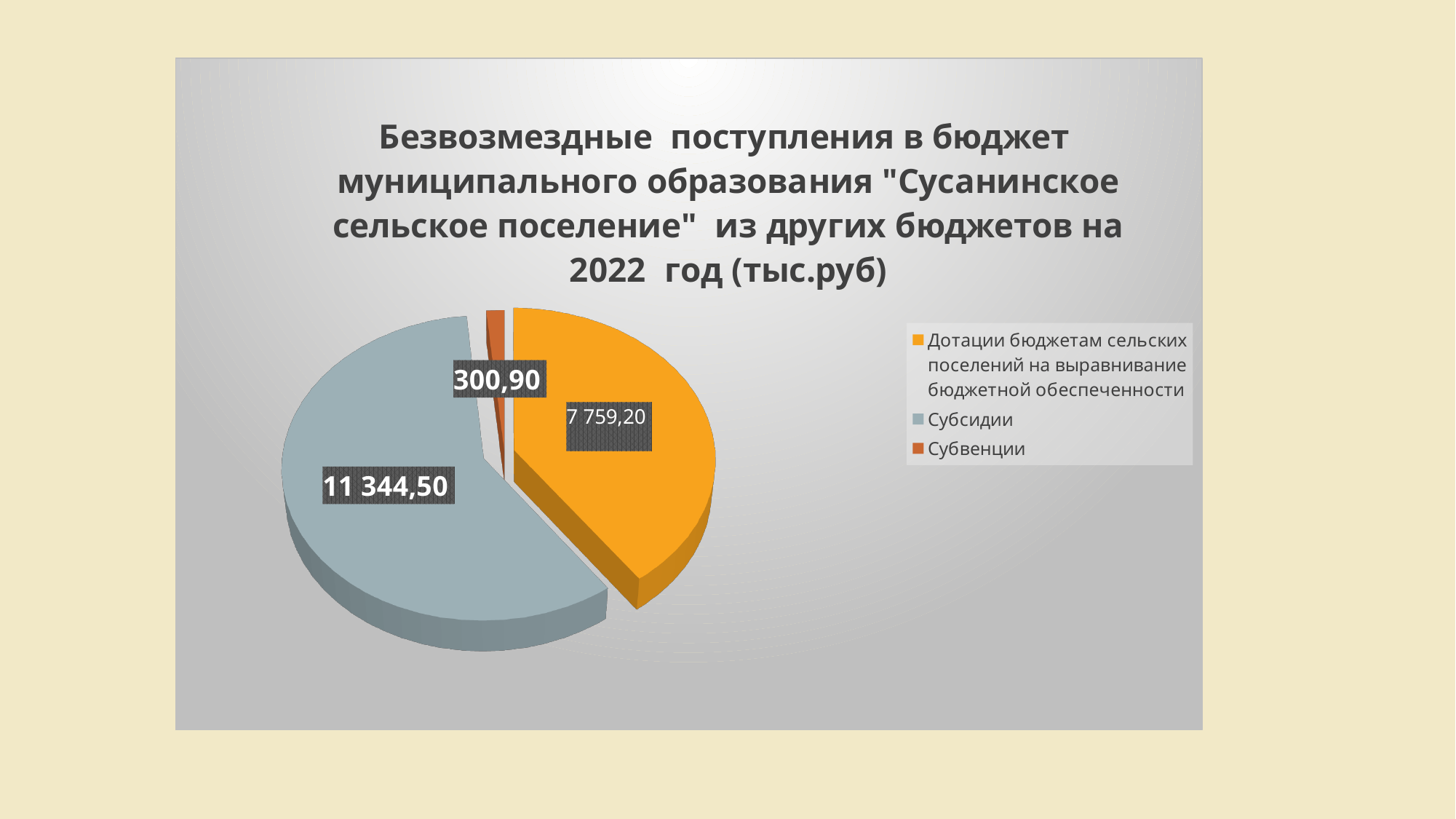
What is the value for Дотации бюджетам сельских поселений на выравнивание бюджетной обеспеченности? 7 759,20 Which is larger: the value for Субсидии or the value for Дотации бюджетам сельских поселений на выравнивание бюджетной обеспеченности? Субсидии How many slices does the pie chart have? 3 What is the difference between the values for Субсидии and Дотации бюджетам сельских поселений на выравнивание бюджетной обеспеченности? 3 585,30 What is the difference between the values for Дотации бюджетам сельских поселений на выравнивание бюджетной обеспеченности and Субвенции? 7 458,30 What colour is the slice for Субвенции? Orange-red (dark orange) Which category has the largest slice of the pie? Субсидии What is the total of all three slices in the pie chart? 19 404,60 What is the value for Субсидии? 11 344,50 What type of chart is shown on the slide? Pie chart What is the value for Субвенции? 300,90 Which category has the smallest slice of the pie? Субвенции